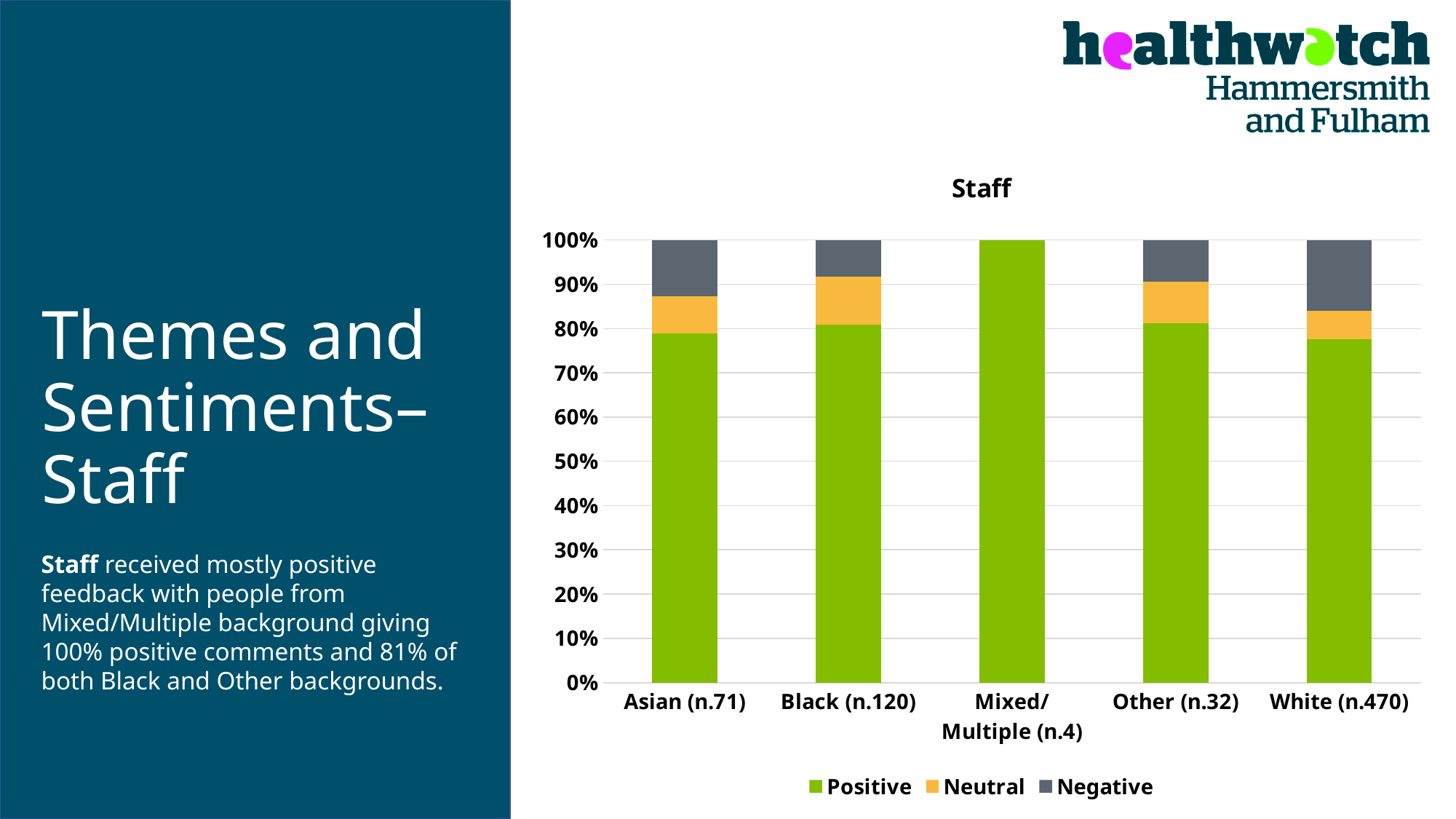
Which category has the highest Positive share? Mixed/Multiple (n.4) Which category has the largest Negative share? White (n.470) Which colour represents the Positive series in the legend? Green Which is larger, the Positive share for Mixed/Multiple (n.4) or for White (n.470)? Mixed/Multiple (n.4) What type of chart is shown on the slide? Stacked bar chart How many series does the chart's legend list? 3 Is the Positive value for White (n.470) greater or less than 90%? less How many categories are shown on the x axis of the chart? 5 Is the Positive value for Asian (n.71) greater or less than 70%? greater What is the Positive value for Mixed/Multiple (n.4)? 100% Is the Negative value for Black (n.120) greater or less than 20%? less What is the title of the chart? Staff